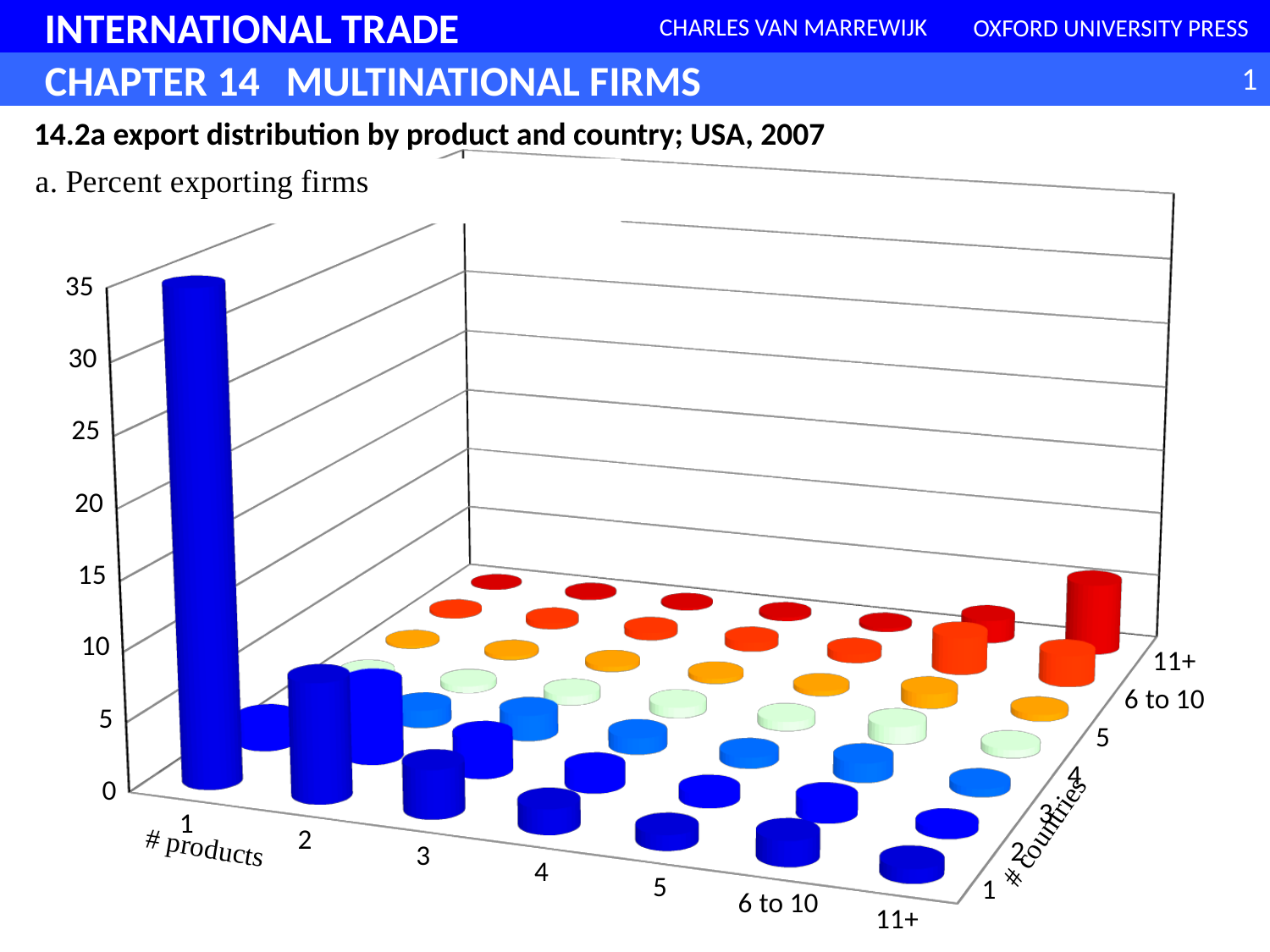
What quantity does the chart plot, according to the label under the title? Percent exporting firms What is the highest tick value shown on the vertical axis? 35 How many categories are shown on the # products axis? 7 Which is larger: the value for 1 product and 1 country, or the value for 11+ products and 11+ countries? 1 product and 1 country Among firms exporting 11+ products, which # countries category has the tallest bar? 11+ What kind of chart is shown on the slide? bar chart How many categories are shown on the # countries axis? 7 Which combination of # products and # countries has the highest percent of exporting firms? 1 product, 1 country Is the value for firms with 1 product and 1 country greater or less than 30? greater What is the title of the chart on the slide? 14.2a export distribution by product and country; USA, 2007